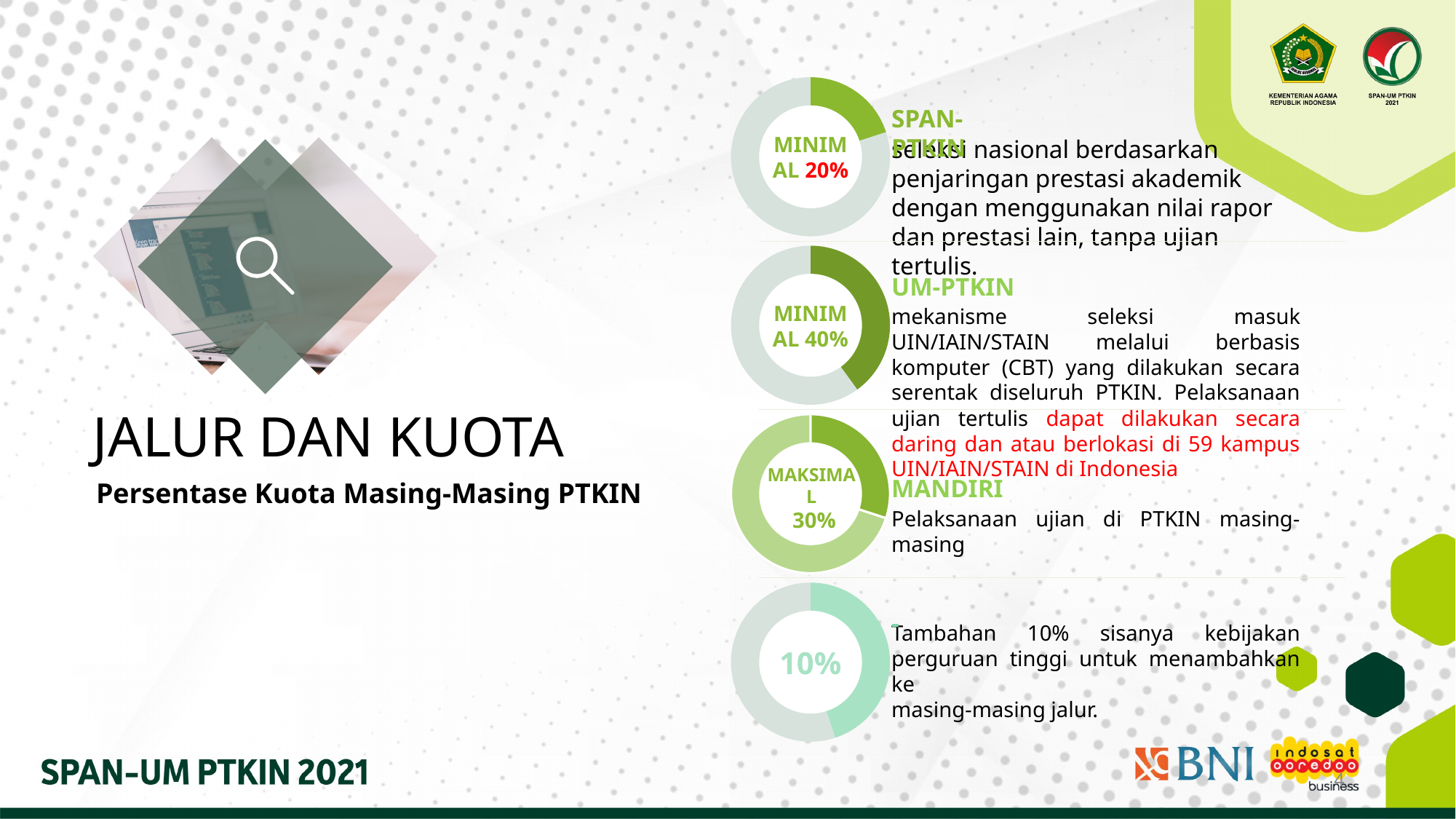
What percentage is shown in the centre of the top donut chart (next to SPAN-PTKIN)? 20% Which is larger, the percentage in the MANDIRI donut chart or the SPAN-PTKIN donut chart? MANDIRI What is the difference between the percentage in the UM-PTKIN donut chart and the SPAN-PTKIN donut chart? 20% Which of the four donut charts shows the smallest percentage? the bottom chart (10%) What kind of chart is used to show each quota percentage on the slide? donut (pie) chart How many donut charts are shown on the slide? 4 What word appears above the 30% in the third donut chart? MAKSIMAL What percentage is shown in the centre of the third donut chart (next to MANDIRI)? 30% What percentage is shown in the centre of the second donut chart (next to UM-PTKIN)? 40% Which of the four donut charts shows the largest percentage? UM-PTKIN (40%) What is the total of the four percentages shown in the donut charts? 100% What percentage is shown in the centre of the bottom donut chart? 10%